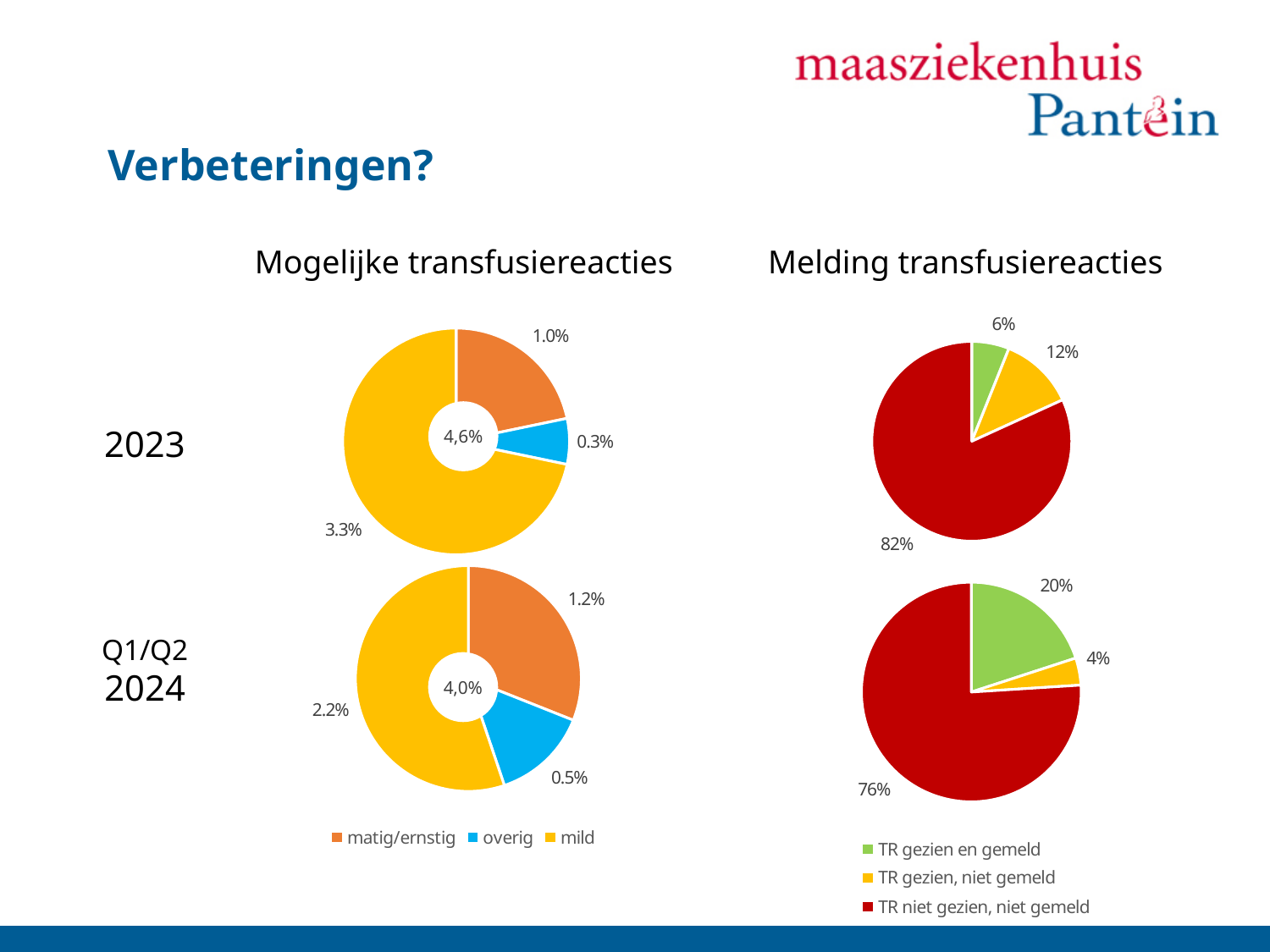
What is the difference between the 'TR niet gezien, niet gemeld' share in the 2023 and the Q1/Q2 2024 'Melding transfusiereacties' charts? 6% In the 'Mogelijke transfusiereacties' charts, is the value for overig larger in 2023 or in Q1/Q2 2024? Q1/Q2 2024 How many categories does the legend of the 'Melding transfusiereacties' charts list? 3 In the 2023 'Melding transfusiereacties' chart, what is the share for 'TR gezien, niet gemeld'? 12% In the Q1/Q2 2024 'Melding transfusiereacties' chart, what is the share for 'TR gezien en gemeld'? 20% In the Q1/Q2 2024 'Mogelijke transfusiereacties' chart, what is the value for matig/ernstig? 1.2% In the 2023 'Mogelijke transfusiereacties' chart, which category has the smallest value? overig In the 2023 'Melding transfusiereacties' chart, which category has the smallest slice? TR gezien en gemeld What value is printed in the centre of the Q1/Q2 2024 'Mogelijke transfusiereacties' chart? 4,0% What kind of chart is used for 'Melding transfusiereacties'? Pie chart In the Q1/Q2 2024 'Melding transfusiereacties' chart, which category has the largest slice? TR niet gezien, niet gemeld In the 2023 'Mogelijke transfusiereacties' chart, what is the value for mild? 3.3%